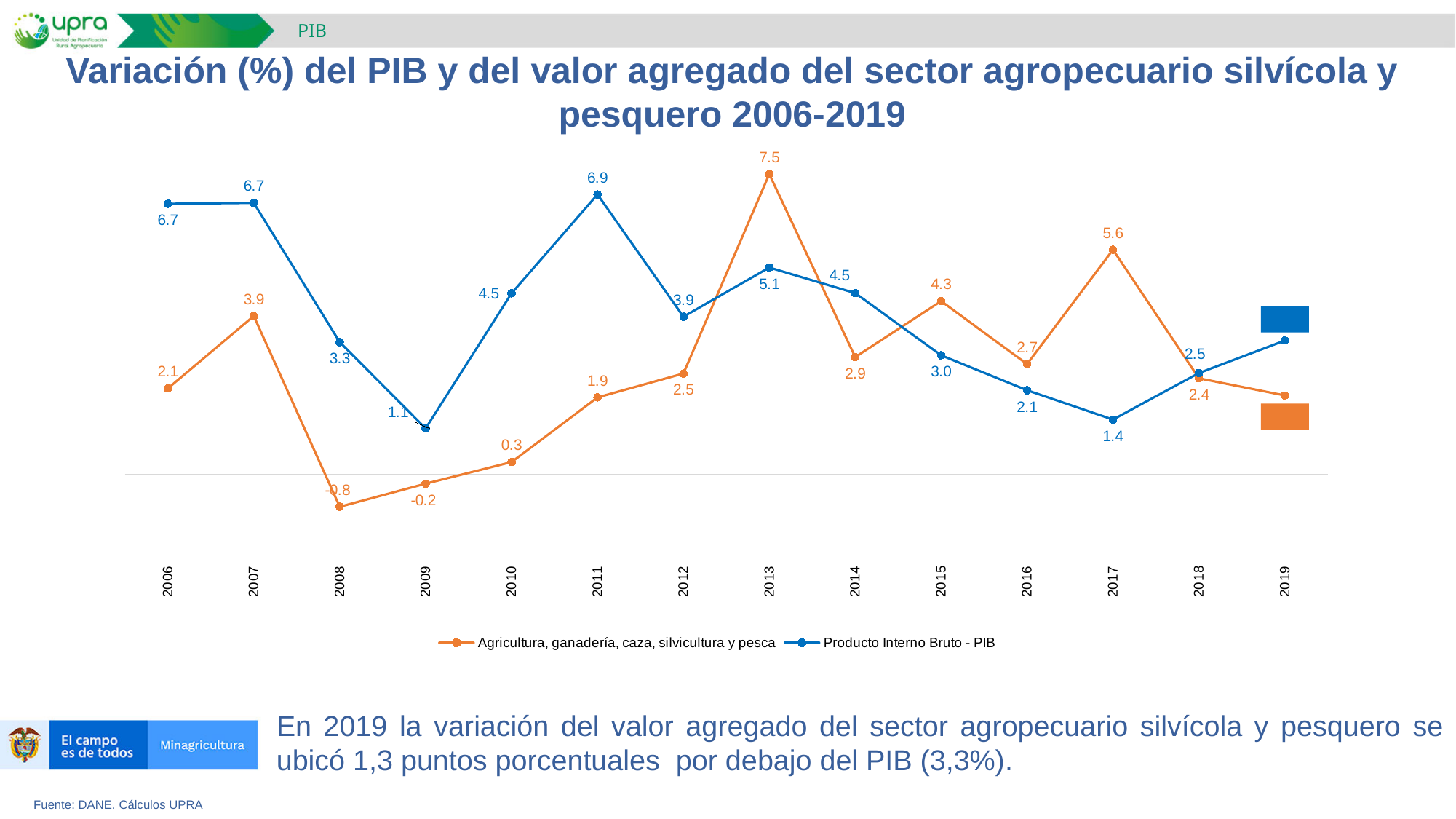
What is the value of the Agricultura, ganadería, caza, silvicultura y pesca series in 2013? 7.5 In 2013, how much higher is the Agricultura, ganadería, caza, silvicultura y pesca value than the Producto Interno Bruto - PIB value? 2.4 How many series does the chart legend list? 2 What type of chart is shown on the slide? Line chart Does the Producto Interno Bruto - PIB series rise or fall from 2014 to 2017? Fall How many years are shown on the x axis of the chart? 14 In which year does the Producto Interno Bruto - PIB series reach its lowest value? 2009 In which year does the Agricultura, ganadería, caza, silvicultura y pesca series reach its lowest value? 2008 What is the value of the Agricultura, ganadería, caza, silvicultura y pesca series in 2009? -0.2 In which year does the Agricultura, ganadería, caza, silvicultura y pesca series reach its highest value? 2013 In 2008, which series has the larger value: Agricultura, ganadería, caza, silvicultura y pesca or Producto Interno Bruto - PIB? Producto Interno Bruto - PIB What is the value of the Producto Interno Bruto - PIB series in 2011? 6.9